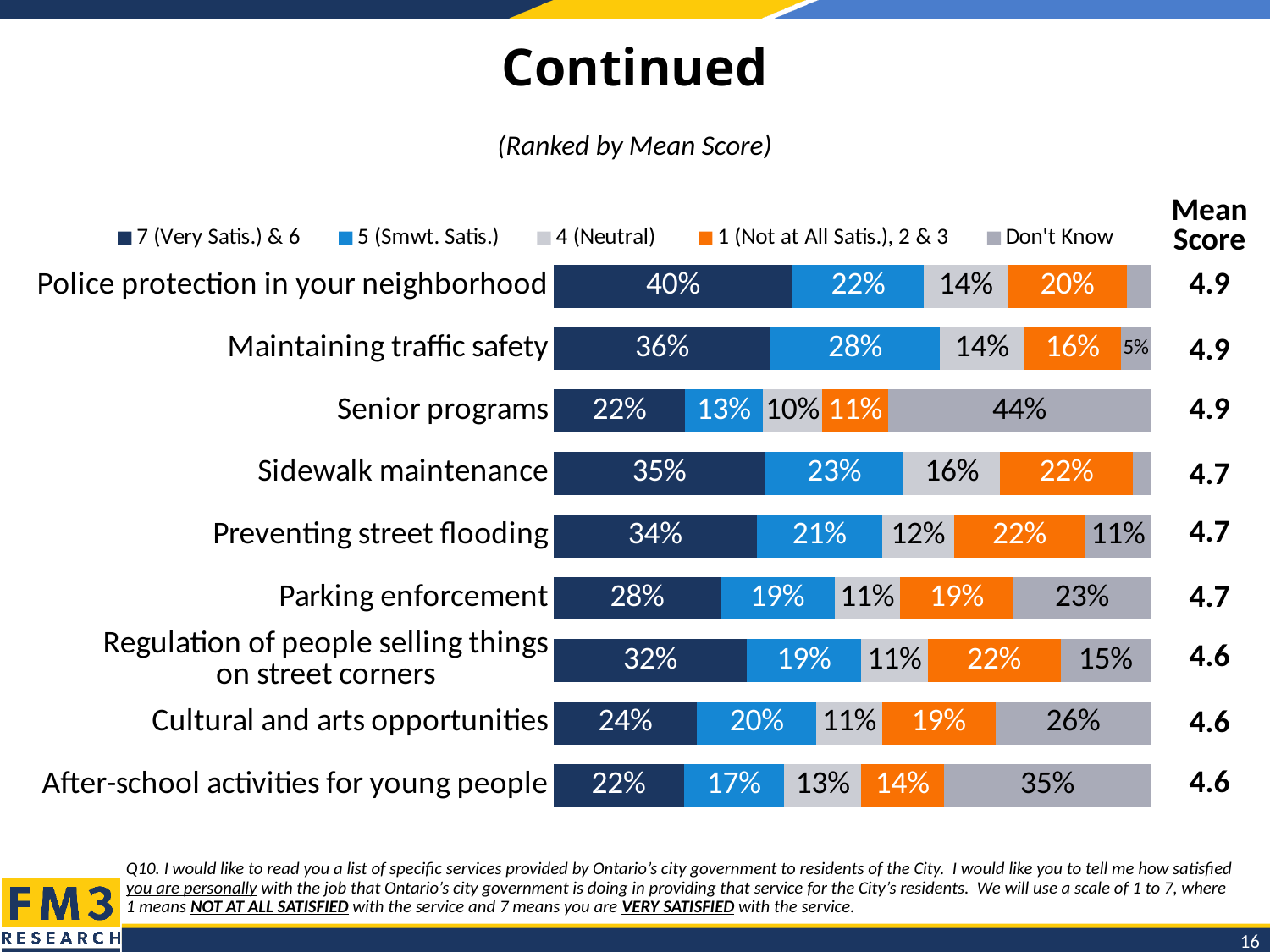
What is the Mean Score shown for After-school activities for young people? 4.6 What kind of chart is shown on the slide? Stacked bar chart How many percentage points higher is the "7 (Very Satis.) & 6" share for Police protection in your neighborhood than for Senior programs? 18 percentage points Which service has the lowest "1 (Not at All Satis.), 2 & 3" percentage? Senior programs What is the "5 (Smwt. Satis.)" percentage for Maintaining traffic safety? 28% Which has a larger "5 (Smwt. Satis.)" share: Maintaining traffic safety or Police protection in your neighborhood? Maintaining traffic safety What percentage of respondents gave "7 (Very Satis.) & 6" for Police protection in your neighborhood? 40% What is the "Don't Know" percentage for Senior programs? 44% Which service has the highest "7 (Very Satis.) & 6" percentage? Police protection in your neighborhood How many series does the legend list? 5 What percentage gave "1 (Not at All Satis.), 2 & 3" for Sidewalk maintenance? 22% How many services are listed in the chart? 9